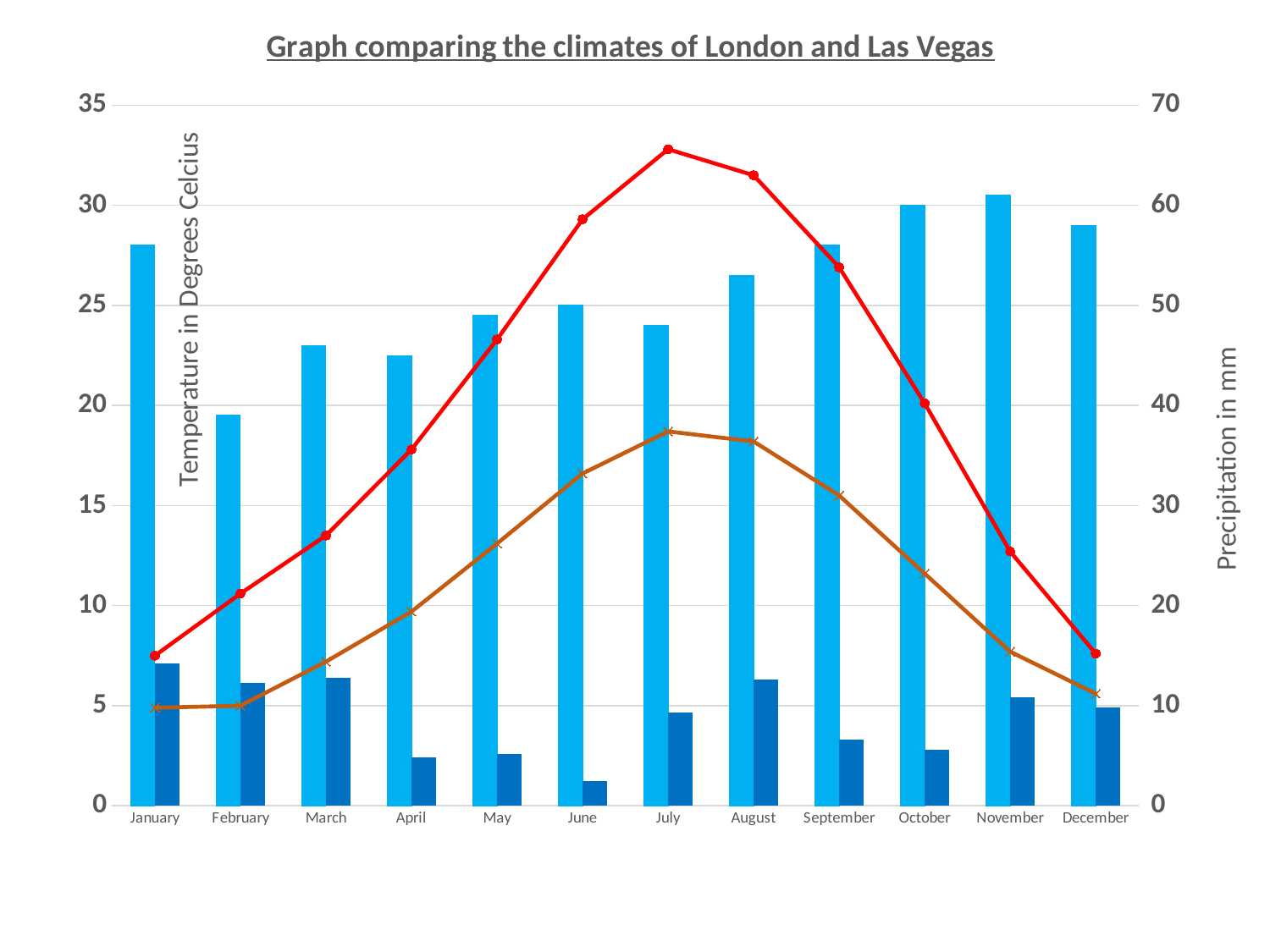
In which month does the red line reach its highest point? July What kind of chart is shown on the slide? A combined bar and line chart In which month is the dark blue bar the shortest? June Is the value of the red line in July greater or less than 30? greater What is the title of the chart? Graph comparing the climates of London and Las Vegas In July, which is higher, the red line or the orange line? The red line How many months are shown along the x axis? 12 Does the red line rise or fall from January to July? rise In which month is the dark blue bar the tallest? January What does the right-hand vertical axis measure? Precipitation in mm In which month does the orange line reach its highest point? July Is the value of the red line in January greater or less than 10? less